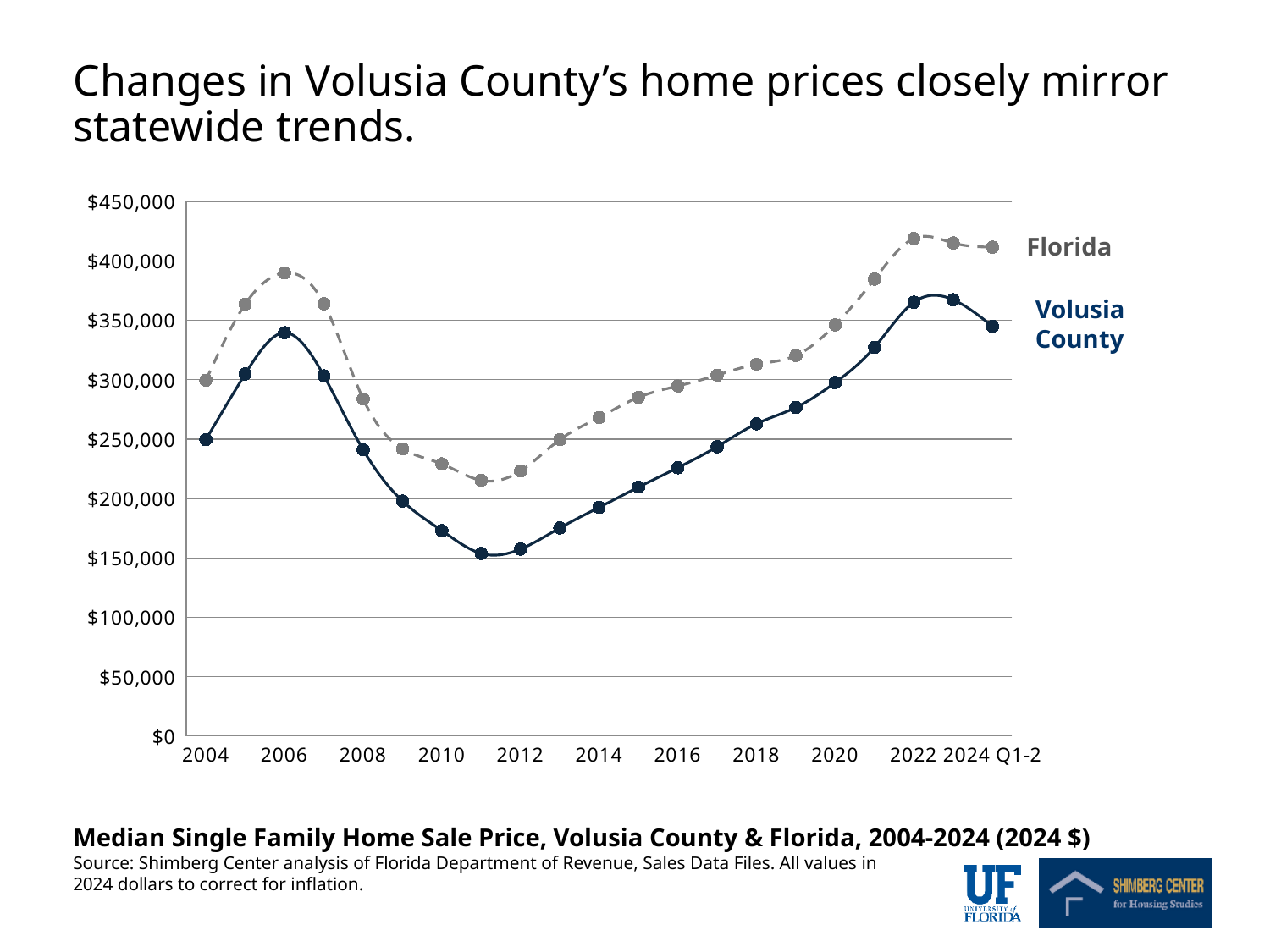
What kind of chart is shown on the slide? line chart Is the Florida value for 2006 greater or less than $350,000? greater Is the Volusia County value for 2024 Q1-2 greater or less than $300,000? greater What are the names of the two series plotted on the chart? Florida and Volusia County In 2022, which series has the higher value, Florida or Volusia County? Florida In which year does the Florida series reach its highest value? 2022 What is the title of the chart? Median Single Family Home Sale Price, Volusia County & Florida, 2004-2024 (2024 $) How many series are plotted on the chart? 2 Do Volusia County values rise or fall from 2011 to 2022? rise In which year does the Volusia County series reach its lowest value? 2011 Is the Volusia County value for 2011 greater or less than $200,000? less